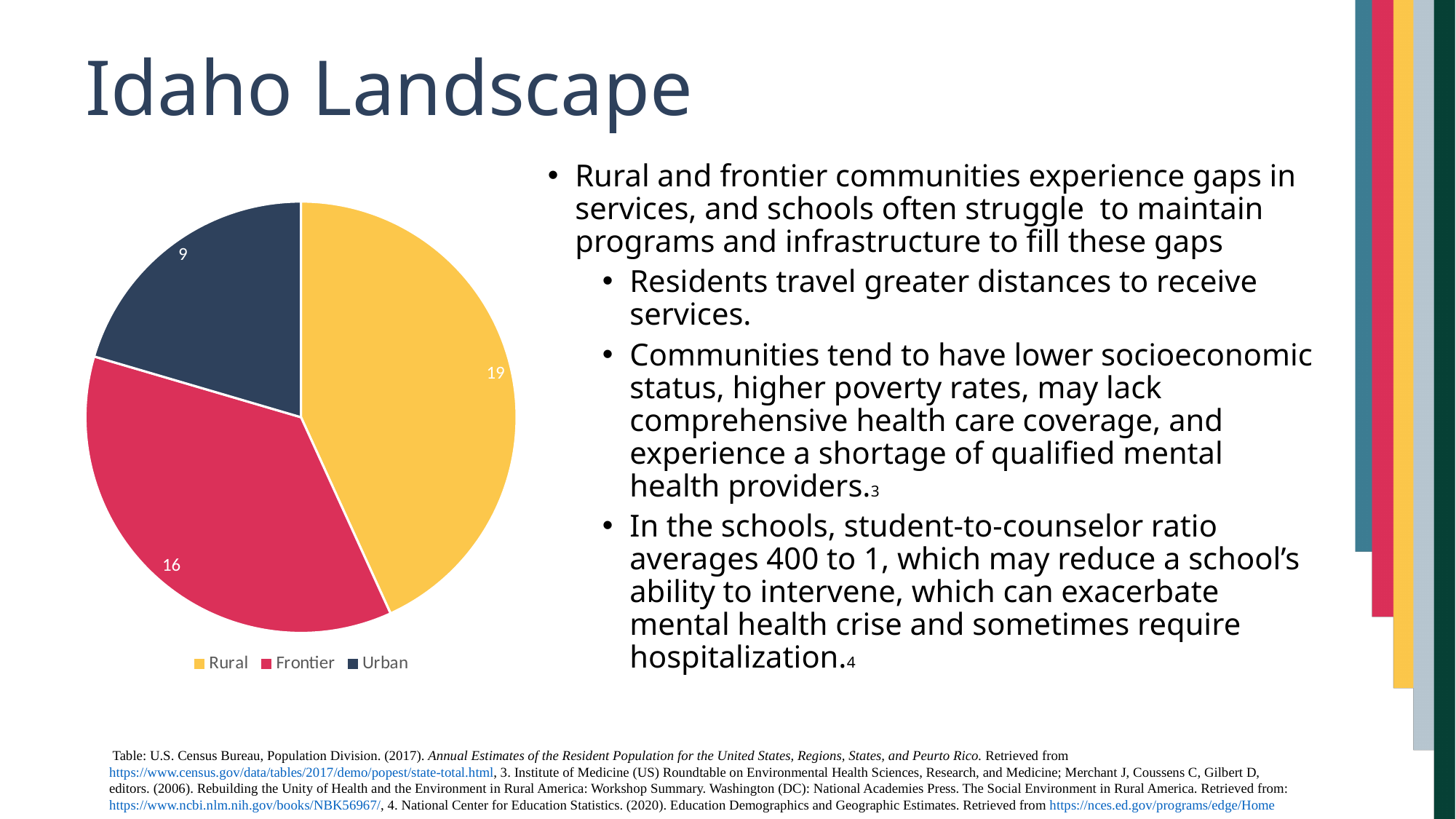
What value is shown for the Rural slice of the pie chart? 19 Which is larger in the pie chart, Frontier or Urban? Frontier What is the difference between the Rural and Urban values in the pie chart? 10 What is the total of all the values shown in the pie chart? 44 Which categories are listed in the pie chart's legend? Rural, Frontier, Urban Which category has the largest slice in the pie chart? Rural What value is shown for the Urban slice of the pie chart? 9 What value is shown for the Frontier slice of the pie chart? 16 What type of chart is shown on the slide? Pie chart How many slices does the pie chart have? 3 What is the difference between the Rural and Frontier values in the pie chart? 3 Which category has the smallest slice in the pie chart? Urban